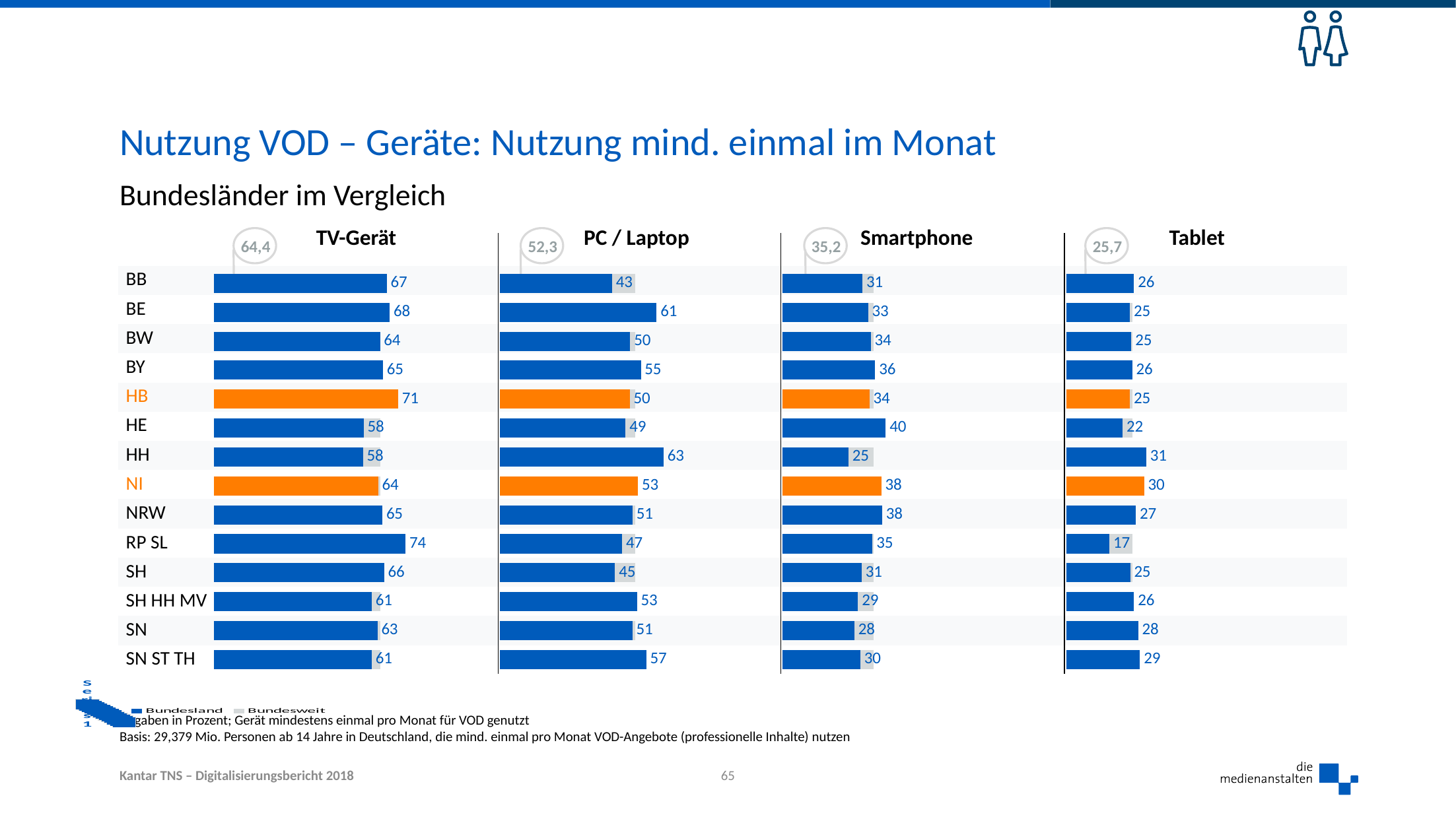
How many categories (Bundesländer) are shown in the TV-Gerät chart? 14 In the Smartphone chart, what is the value for HE? 40 What kind of chart is used for the Tablet data? Bar chart In the Tablet chart, which category has the highest value? HH In the Smartphone chart, which is larger, the value for BY or the value for SN? BY In the TV-Gerät chart, what is the value for HB? 71 In the PC / Laptop chart, which category has the lowest value? BB In the TV-Gerät chart, which category has the highest value? RP SL In the PC / Laptop chart, what is the difference between the values for BE and SH? 16 In the Smartphone chart, which category has the lowest value? HH In the Tablet chart, what is the value for RP SL? 17 In the PC / Laptop chart, what is the value for HH? 63